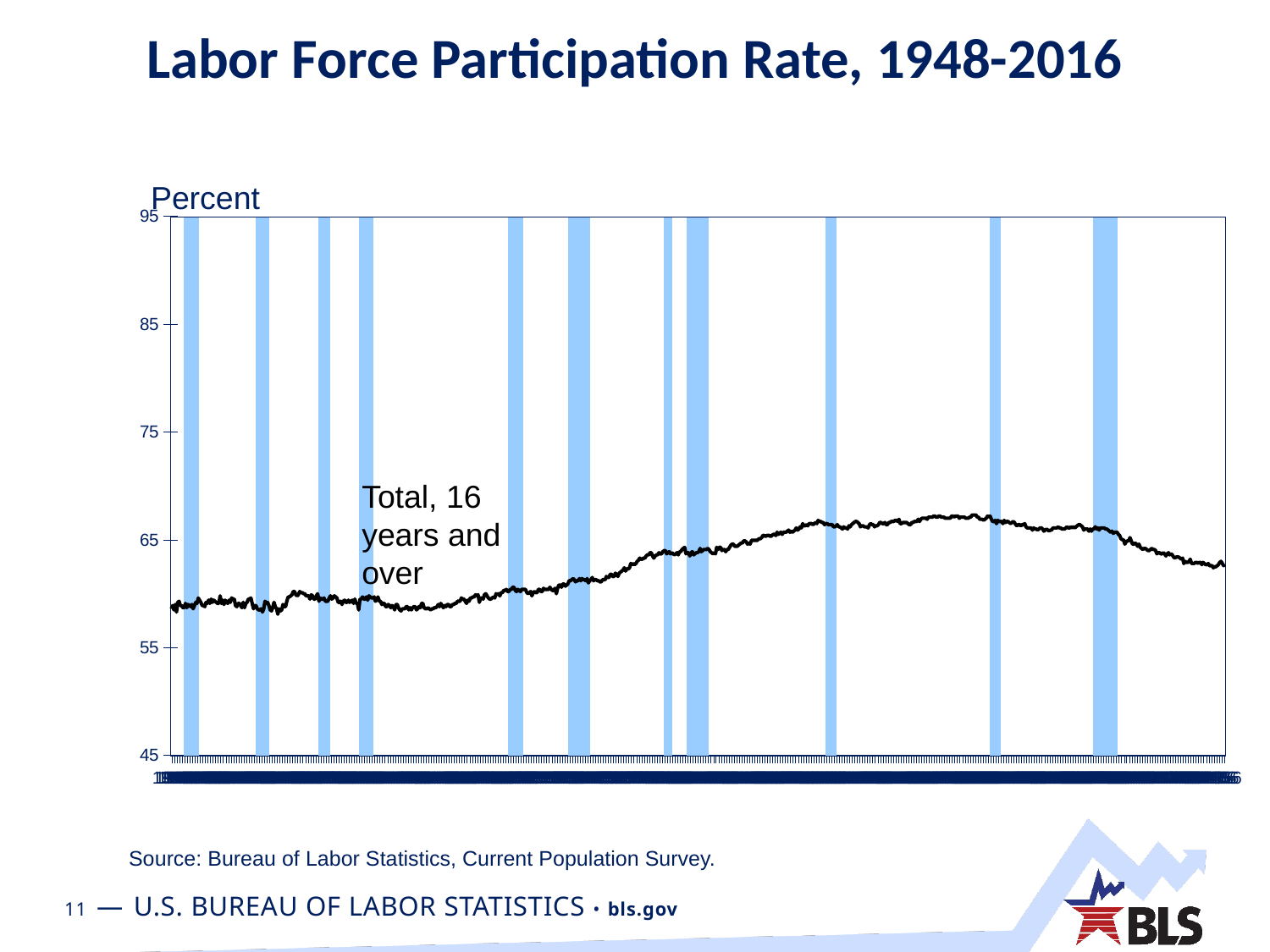
What unit is shown on the vertical axis of the chart? Percent Is the lowest value of the line greater or less than 55? greater What is the label of the plotted series? Total, 16 years and over Is the labor force participation rate at the end of the series (2016) greater or less than 55? greater How many data series are plotted on the chart? 1 Does the line ever reach 75 percent? No What is the title of the chart? Labor Force Participation Rate, 1948-2016 What is the lowest value shown on the vertical axis? 45 What kind of chart is shown on the slide? line chart Does the labor force participation rate rise or fall from its peak (around the late 1990s) to the end of the series in 2016? fall